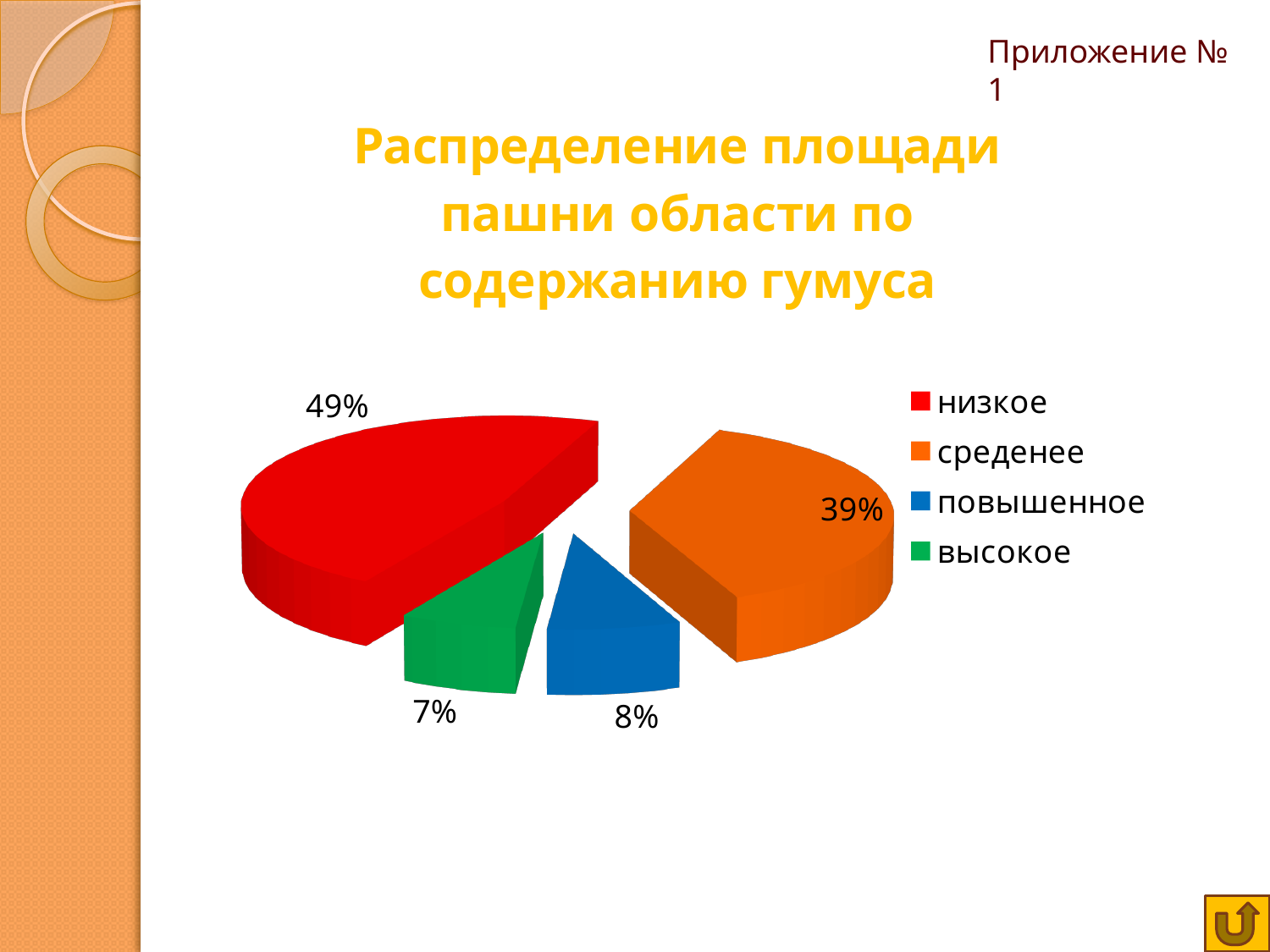
Which slice is larger, 'повышенное' or 'высокое'? повышенное What colour is the 'среденее' slice? orange How many categories are shown in the pie chart? 4 What share of the pie does the 'низкое' slice represent? 49% What share of the pie does the 'высокое' slice represent? 7% What is the difference in percentage points between the 'низкое' and 'среденее' slices? 10% What share of the pie does the 'среденее' slice represent? 39% What is the title of the chart? Распределение площади пашни области по содержанию гумуса Which category has the largest slice of the pie? низкое Which category has the smallest slice of the pie? высокое What kind of chart is shown on the slide? pie chart